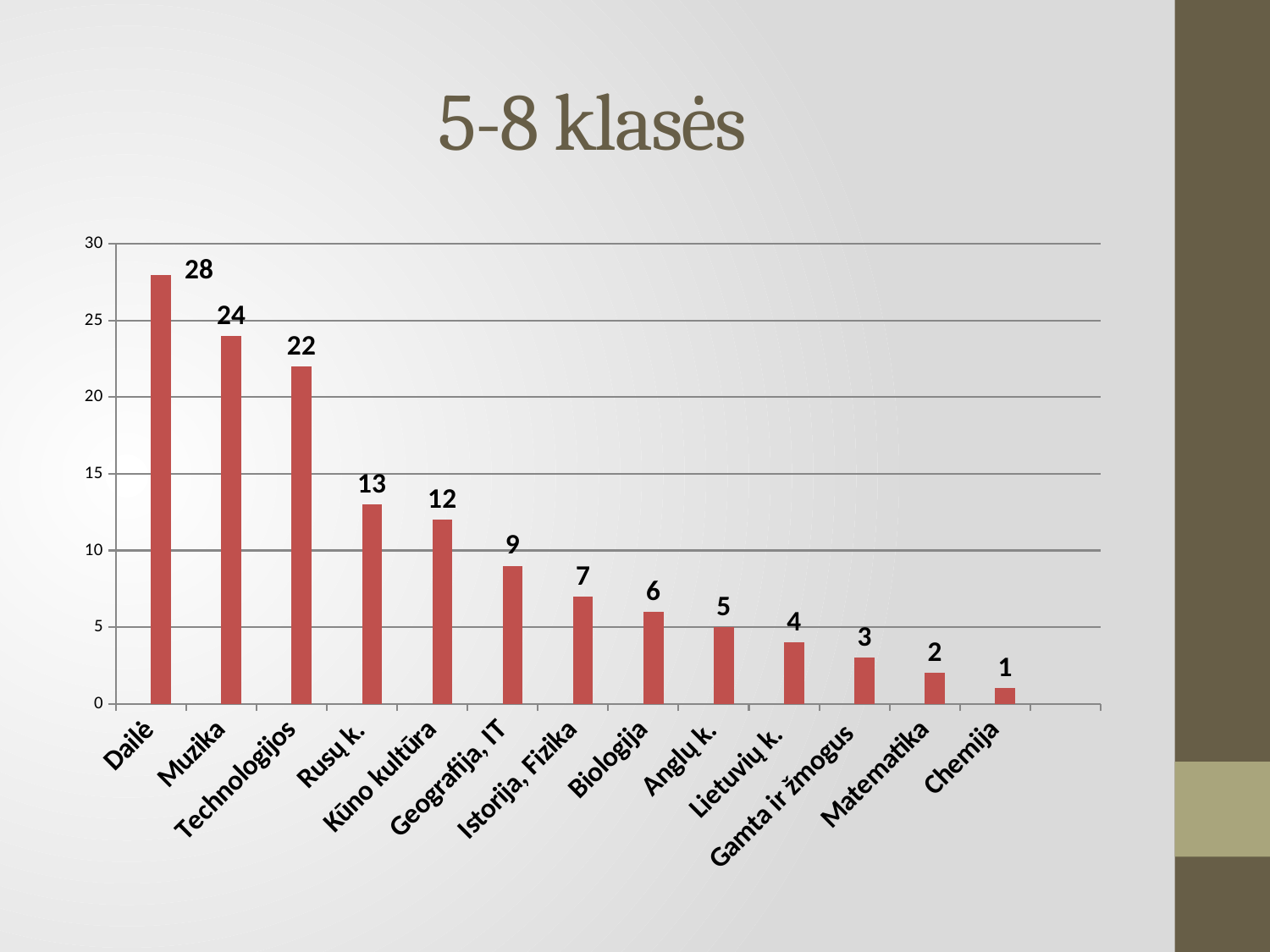
What is the value for Dailė? 28 What is the value for Kūno kultūra? 12 How many categories are shown on the x axis? 13 Is the value for Technologijos greater or less than 20? greater What is the value for Gamta ir žmogus? 3 What is the difference between the values for Rusų k. and Biologija? 7 Which category has the highest value? Dailė Which is larger, the value for Geografija, IT or the value for Anglų k.? Geografija, IT Which category has the lowest value? Chemija What is the difference between the values for Muzika and Technologijos? 2 What is the title of the slide? 5-8 klasės What kind of chart is shown on the slide? bar chart